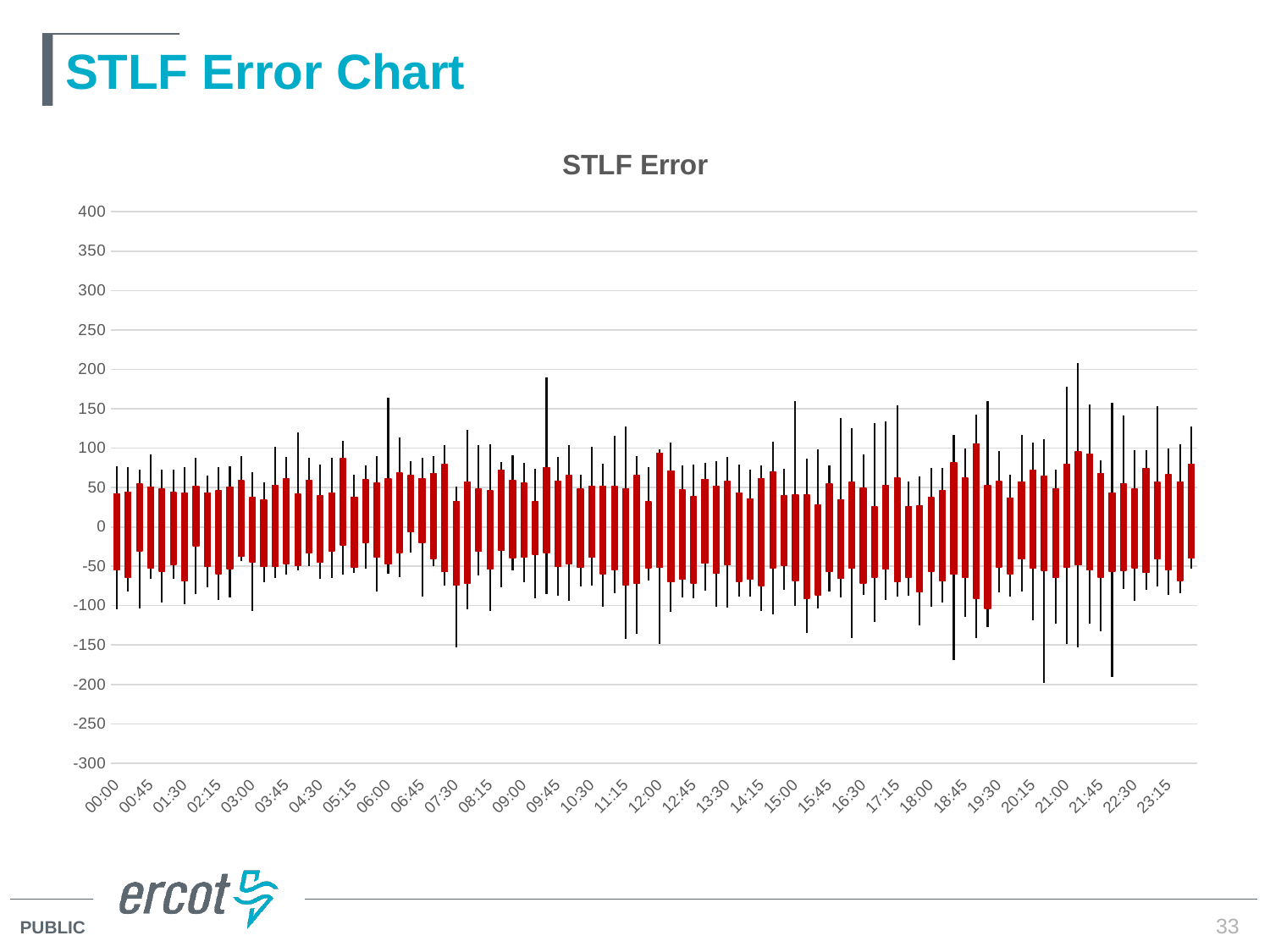
Is the top of the red box at 00:00 greater or less than 100? less Is the highest point plotted on the chart greater or less than 250? less Is the lowest point plotted on the chart greater or less than -250? greater What is the last time label on the horizontal axis? 23:15 What is the lowest value shown on the vertical axis? -300 What is the first time label on the horizontal axis? 00:00 Do the values show a clear rising or falling trend across the day? No clear trend